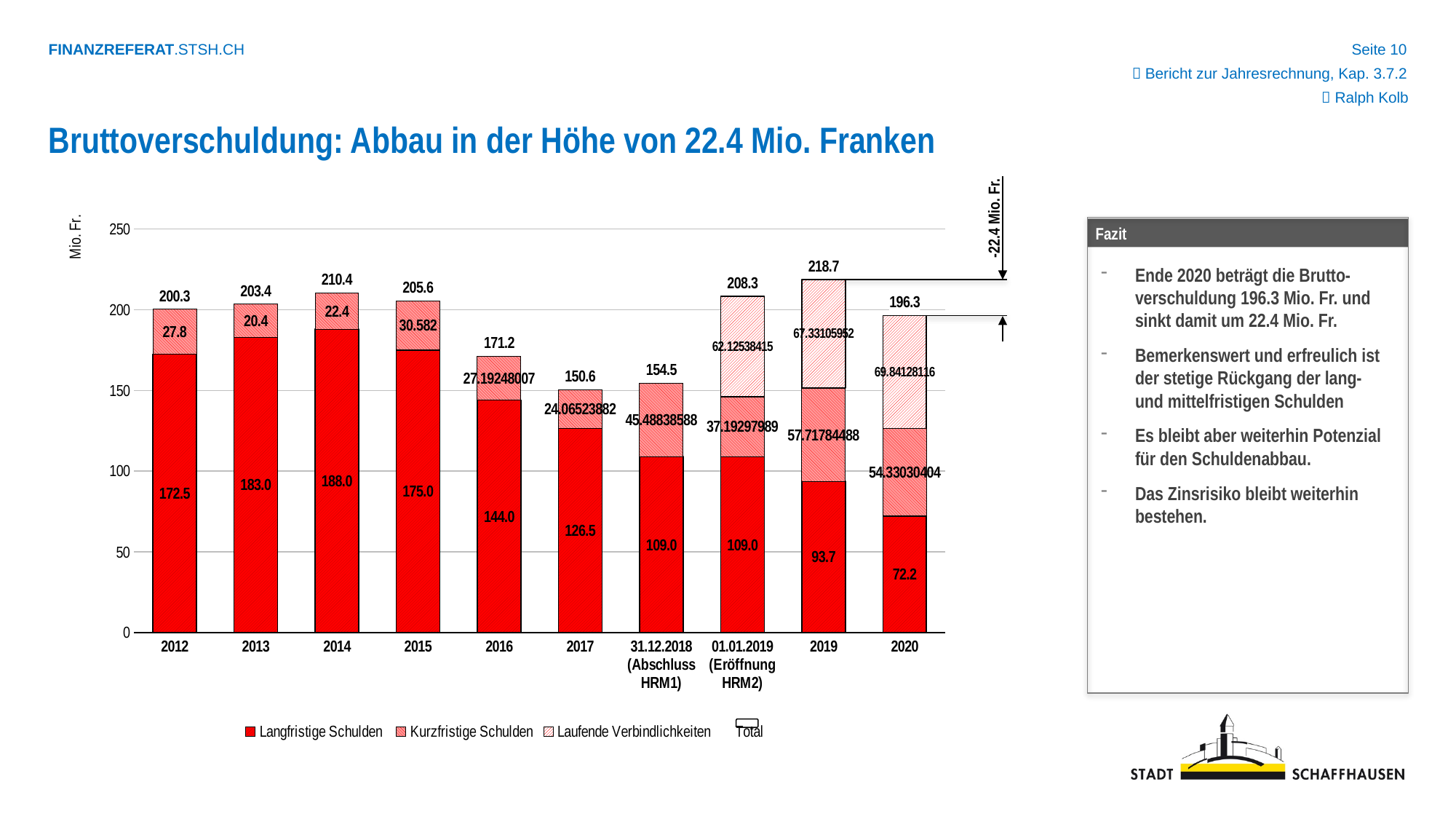
Which category has the highest total value? 2019 How many series does the legend list? 4 Is the value of Langfristige Schulden for 2019 greater or less than 100? less What is the value of Kurzfristige Schulden for 2015? 30.582 What is the value of Langfristige Schulden for 2014? 188.0 Which is larger, Langfristige Schulden in 2013 or in 2015? 2013 What kind of chart is shown on the slide? Stacked bar chart What is the difference between the total for 2019 and the total for 2020? 22.4 Which category has the lowest total value? 2017 Do the values of Langfristige Schulden rise or fall from 2014 to 2020? fall What is the total Bruttoverschuldung shown for 2019? 218.7 How many categories are shown on the x axis? 10